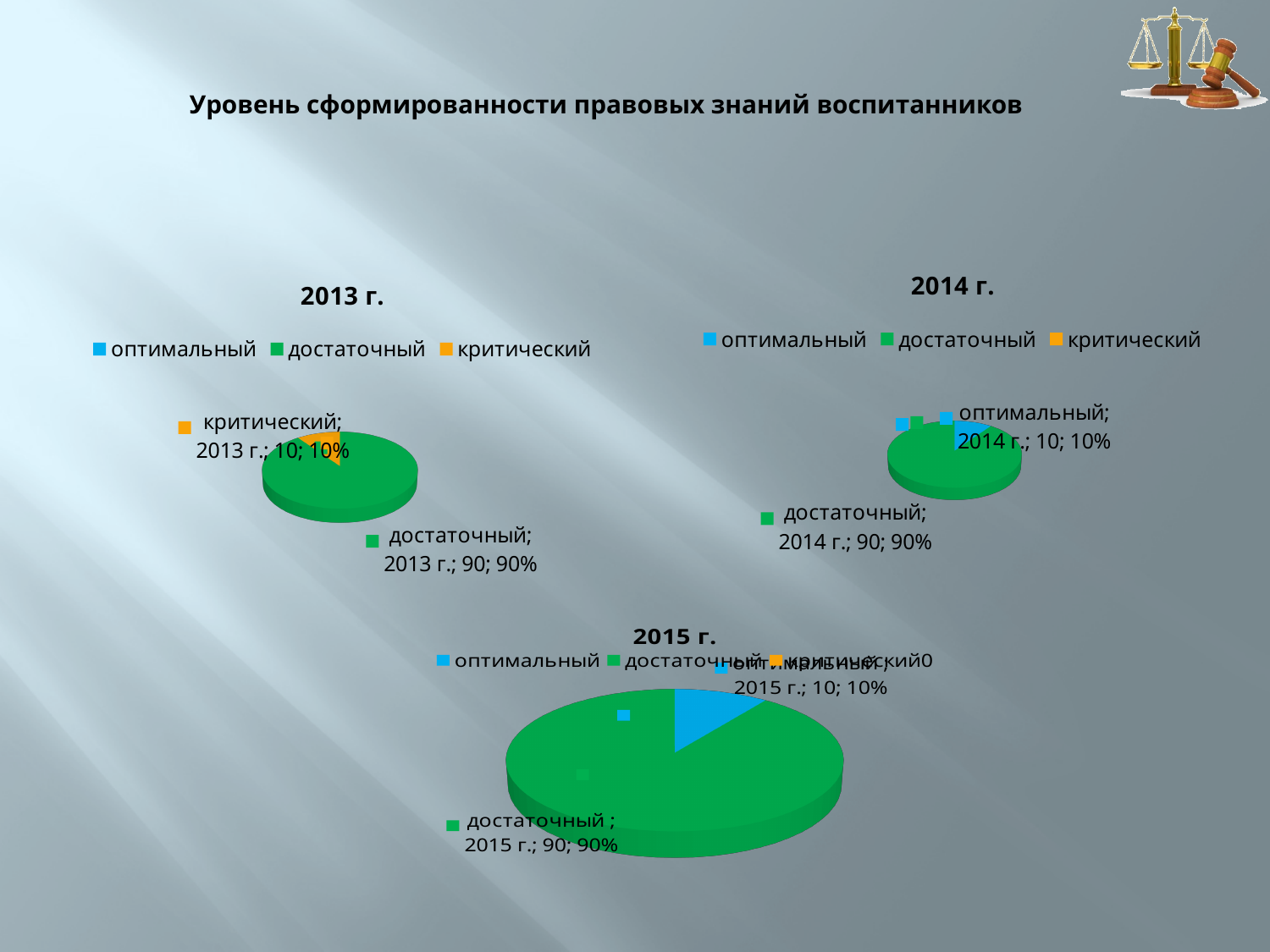
In the "2013 г." chart, what percentage share does "достаточный" have? 90% In the "2013 г." chart, what is the value for "критический"? 10 In the "2013 г." chart, which category has the largest slice? достаточный In the "2015 г." chart, which is larger, "достаточный" or "оптимальный"? достаточный In the "2014 г." chart, what is the value for "оптимальный"? 10 What kind of chart is the "2013 г." chart? pie chart In the "2015 г." chart, what percentage share does "оптимальный" have? 10% What is the title of the slide above the three charts? Уровень сформированности правовых знаний воспитанников In the "2014 г." chart, what percentage share does "достаточный" have? 90% In the "2015 г." chart, what is the value for "достаточный"? 90 In the "2014 г." chart, what is the difference between the values for "достаточный" and "оптимальный"? 80 How many entries does the legend of the "2013 г." chart list? 3